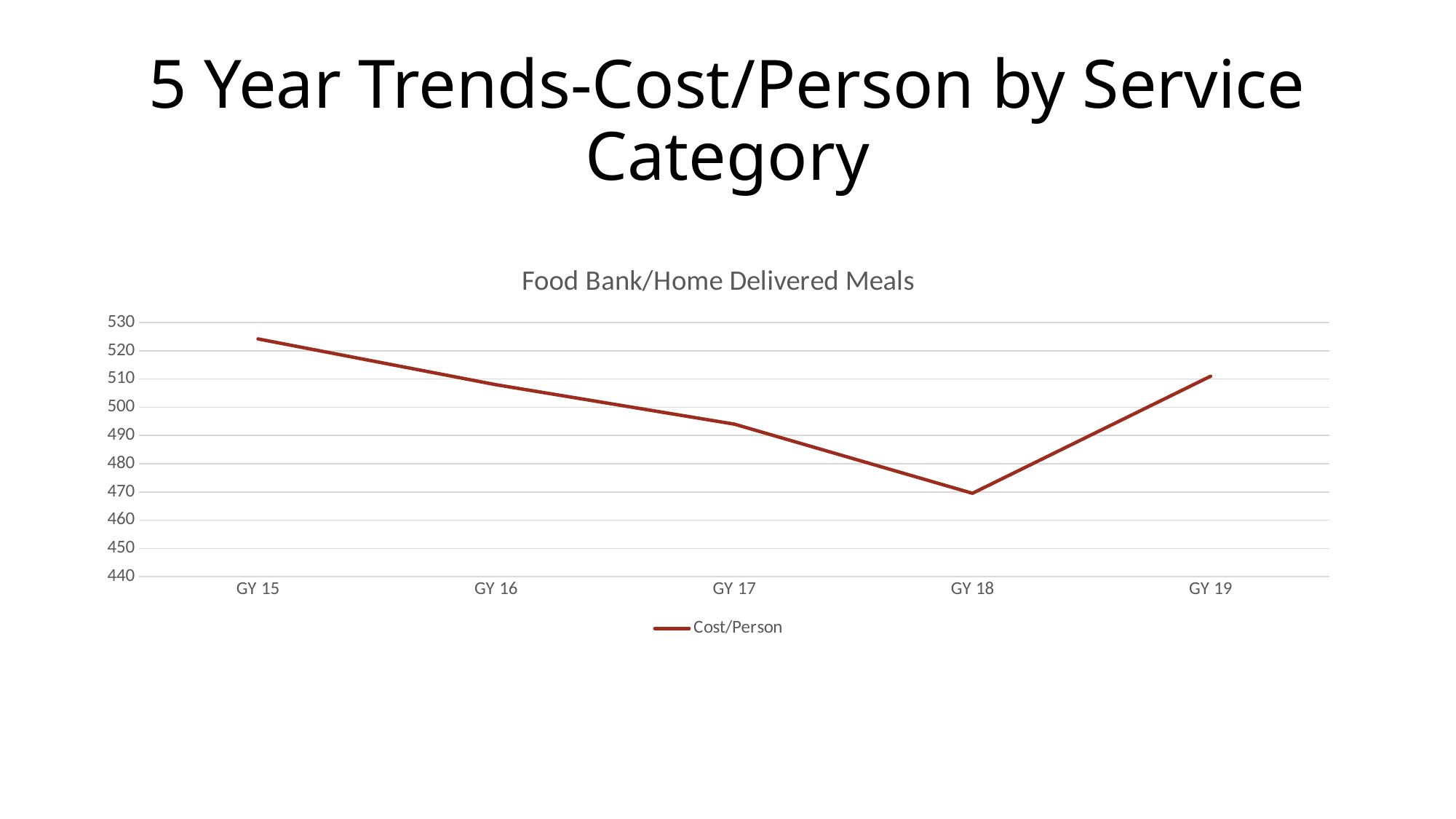
How many years are plotted on the x axis? 5 Does the Cost/Person rise or fall from GY 15 to GY 18? fall How many series does the legend list? 1 Which is larger, the Cost/Person for GY 15 or for GY 19? GY 15 Which year has the highest Cost/Person? GY 15 Is the Cost/Person for GY 16 greater or less than 500? greater Is the Cost/Person for GY 18 greater or less than 480? less Which year has the lowest Cost/Person? GY 18 What kind of chart is shown on the slide? line chart Is the Cost/Person for GY 15 greater or less than 530? less What is the title of the chart? Food Bank/Home Delivered Meals What is the name of the series shown in the legend? Cost/Person